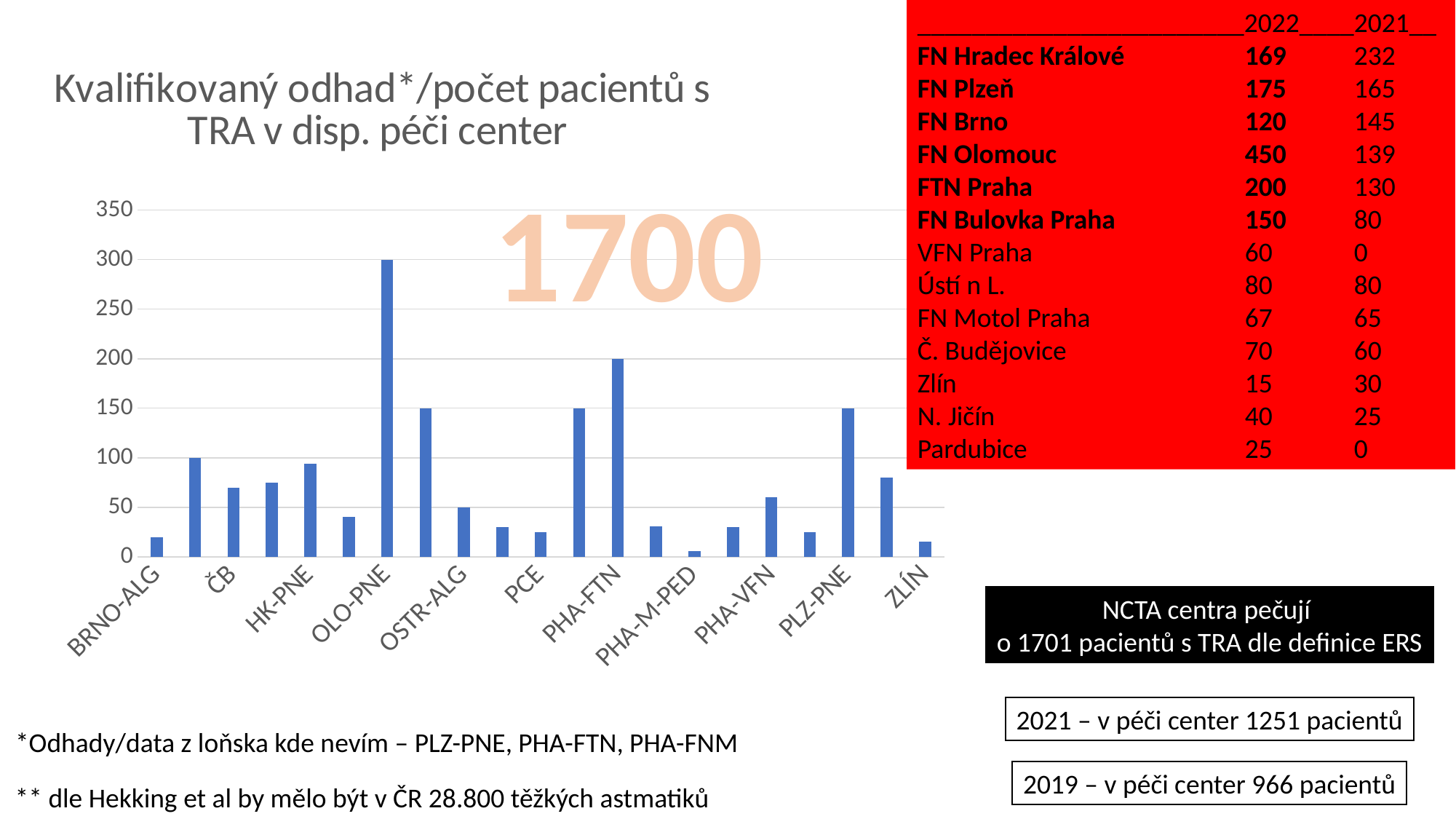
What is the value for PHA-FTN? 200 Which category has the highest bar in the chart? OLO-PNE What is the difference between the values for OLO-PNE and PHA-FTN? 100 Which labelled category has the lowest bar in the chart? PHA-M-PED Is the value for ZLÍN greater or less than 50? less Is the value for ČB greater or less than 100? less What is the title of the chart? Kvalifikovaný odhad*/počet pacientů s TRA v disp. péči center Which is larger, the value for OLO-PNE or the value for PHA-FTN? OLO-PNE What is the value for OLO-PNE? 300 What is the value for PLZ-PNE? 150 What kind of chart is shown on the slide? bar chart Is the value for HK-PNE greater or less than 50? greater